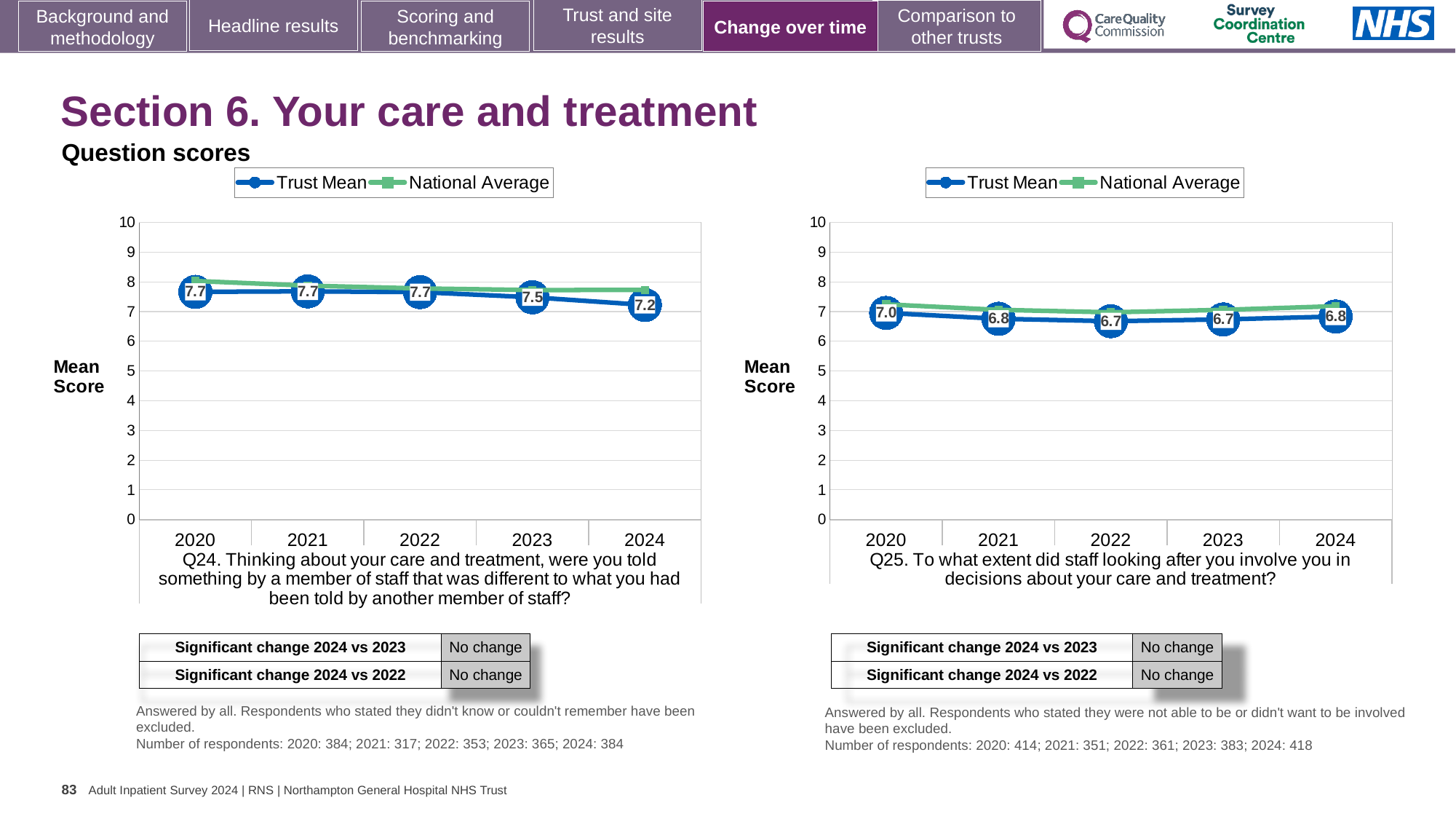
In the Q25 chart on the right, which year has the highest Trust Mean score? 2020 In the Q25 chart on the right, what is the difference between the Trust Mean scores for 2020 and 2022? 0.3 In the Q25 chart on the right, what is the Trust Mean score for 2022? 6.7 In the Q24 chart on the left, is the Trust Mean score for 2021 greater or less than 7? greater In the Q25 chart on the right, what is the Trust Mean score for 2020? 7.0 In the Q24 chart on the left, what is the difference between the Trust Mean scores for 2020 and 2024? 0.5 In the Q24 chart on the left, which year has the lowest Trust Mean score? 2024 In the Q24 chart on the left, does the Trust Mean score rise or fall from 2022 to 2024? Fall In the Q24 chart on the left, what is the Trust Mean score for 2023? 7.5 What kind of chart is the Q24 chart on the left? Line chart How many series does the legend of the Q25 chart on the right list? 2 In the Q24 chart on the left, what is the Trust Mean score for 2024? 7.2